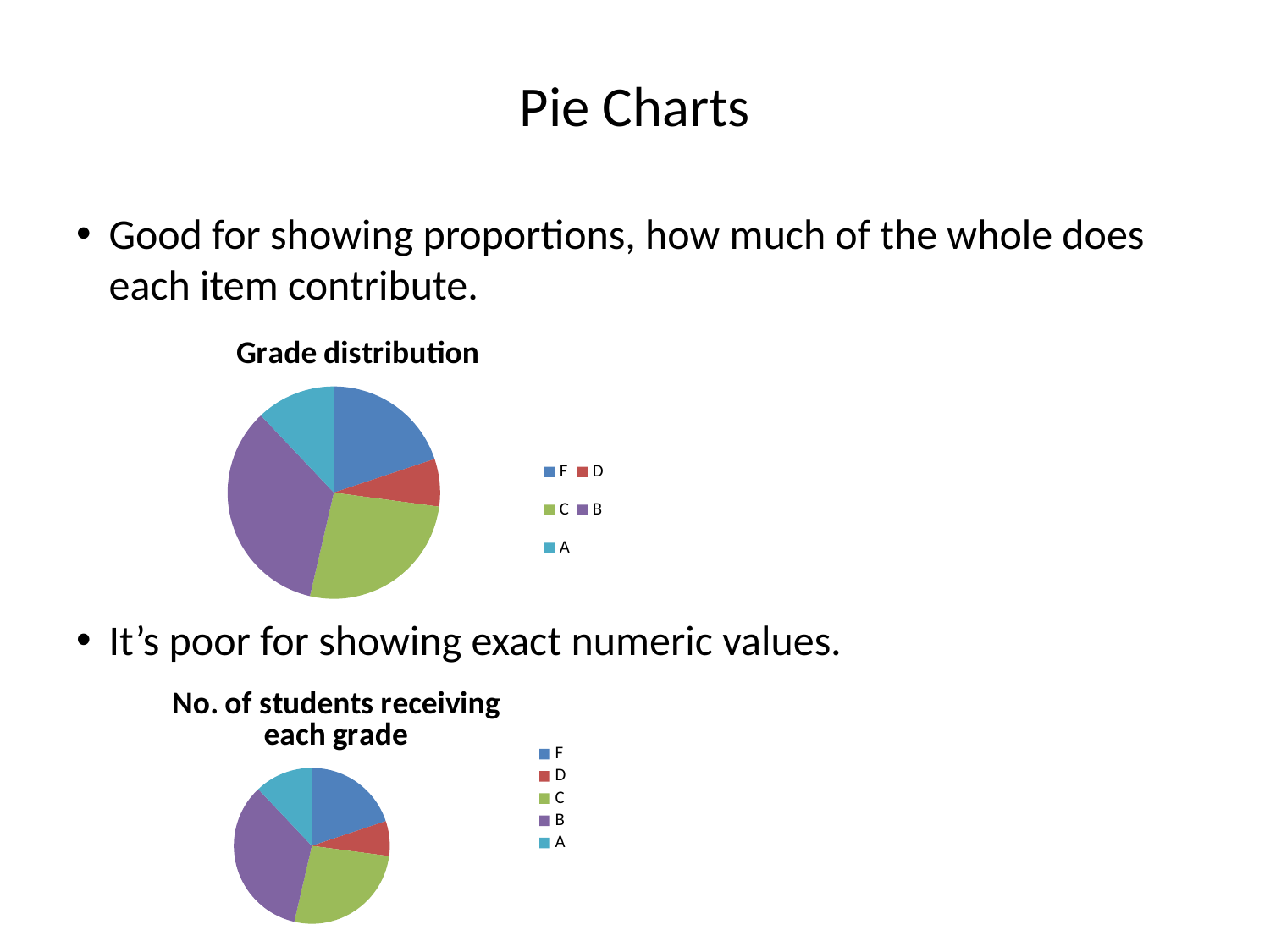
In the "No. of students receiving each grade" chart, which grade has the smallest slice? D In the "Grade distribution" chart, how many slices does the pie have? 5 In the "Grade distribution" chart, which grade has the smallest slice? D In the "Grade distribution" chart, which grade is shown in purple? B In the "No. of students receiving each grade" chart, which slice is larger, B or A? B What kind of chart is the "Grade distribution" chart? pie chart What is the title of the upper pie chart on the slide? Grade distribution In the "Grade distribution" chart, which grade has the largest slice? B In the "No. of students receiving each grade" chart, which grade has the largest slice? B In the "No. of students receiving each grade" chart, how many entries does the legend list? 5 What kind of chart is the "No. of students receiving each grade" chart? pie chart In the "Grade distribution" chart, which slice is larger, C or D? C